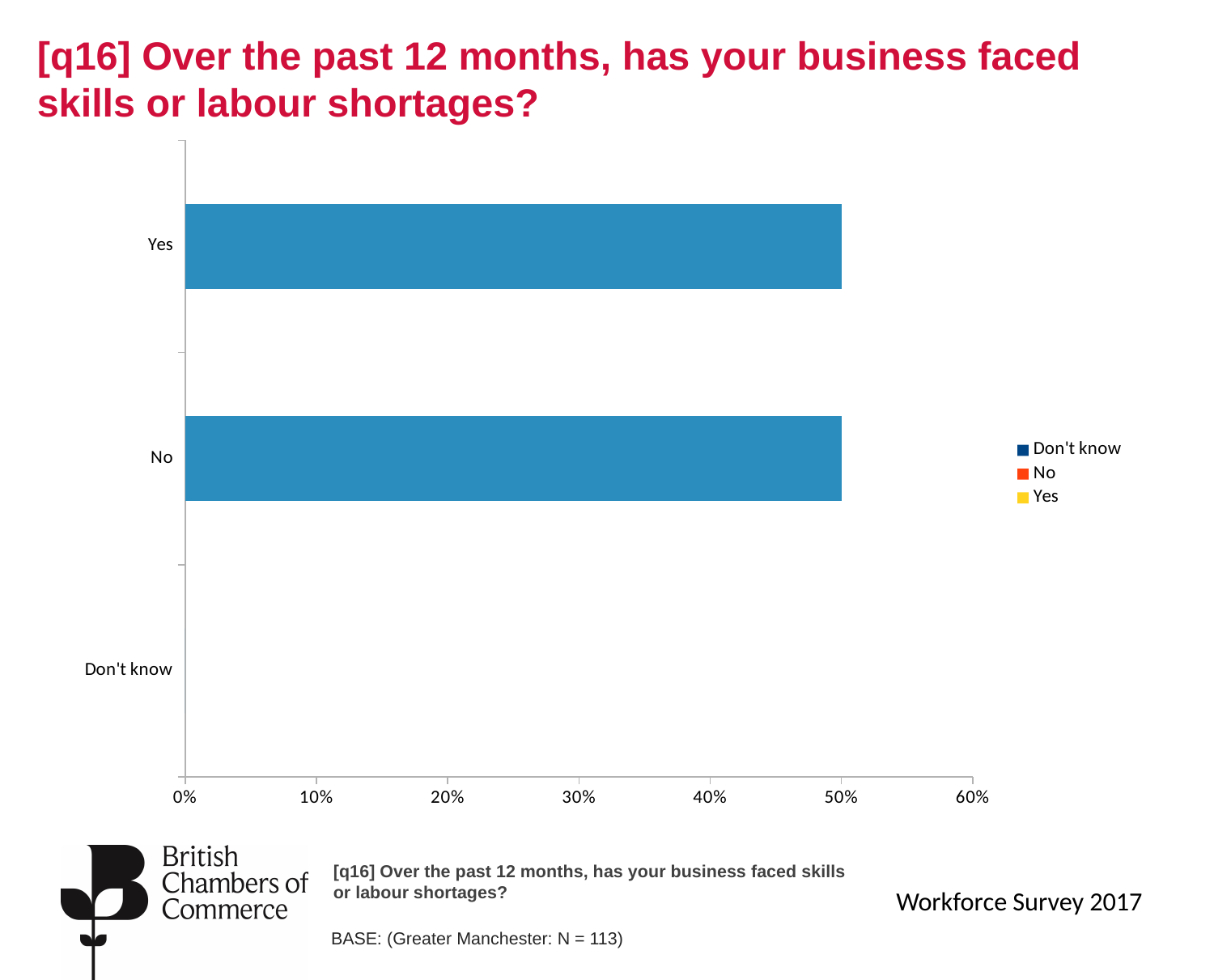
Is the value for 'No' greater or less than 30%? greater How many categories are shown on the vertical axis of the chart? 3 Which is larger, the value for 'Yes' or the value for 'Don't know'? Yes How many entries does the chart's legend list? 3 What is the value for 'Yes'? 50% What kind of chart is shown on the slide? bar chart What is the title of the chart? [q16] Over the past 12 months, has your business faced skills or labour shortages? Is the value for 'Yes' greater or less than 40%? greater Which category has the lowest value? Don't know What is the value for 'No'? 50% What is the highest value shown on the horizontal axis? 60%